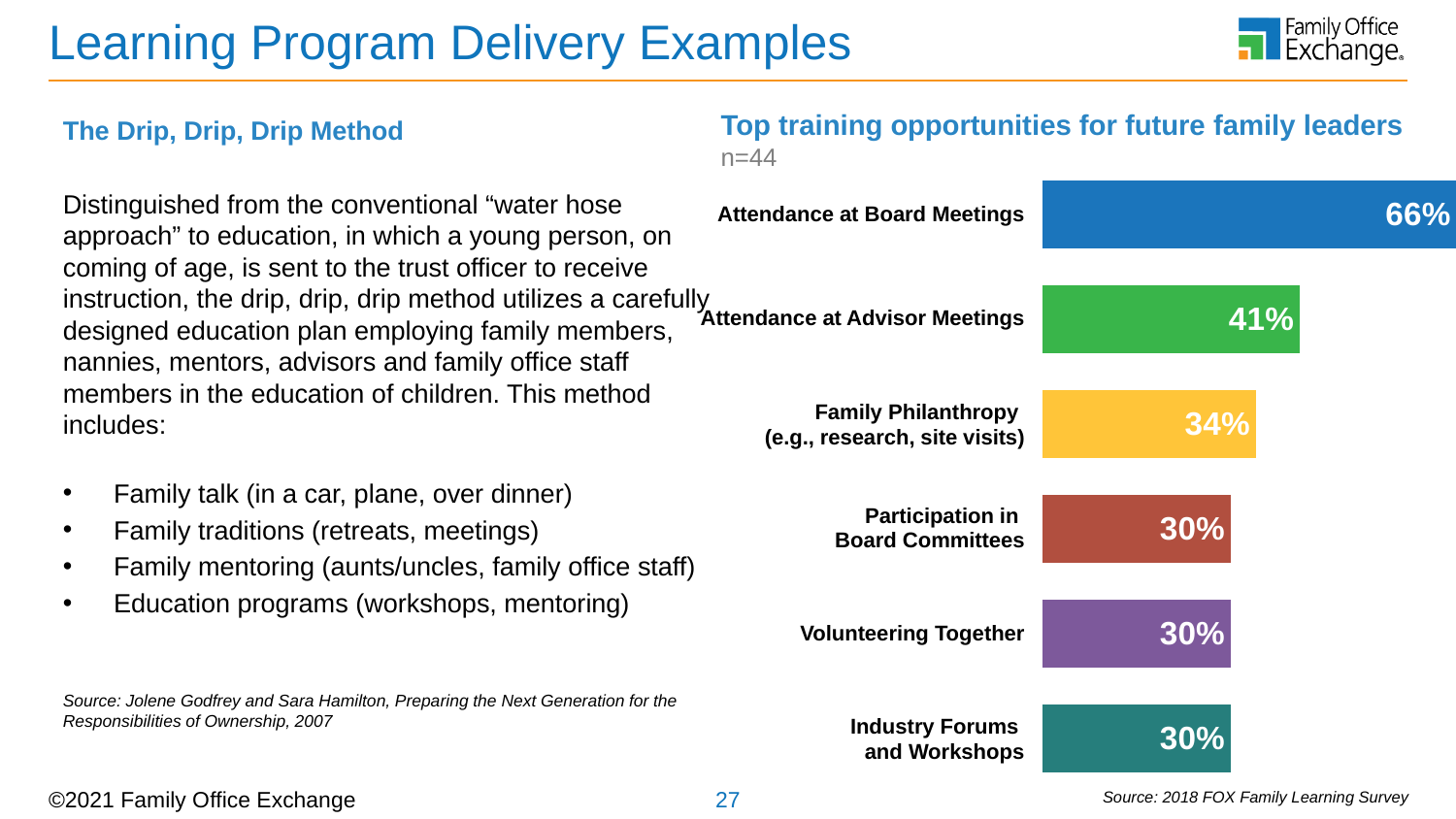
Which training opportunity has the highest percentage? Attendance at Board Meetings What is the value for Attendance at Advisor Meetings? 41% What is the value for Volunteering Together? 30% What is the difference between Family Philanthropy and Participation in Board Committees? 4% What percentage is shown for Attendance at Board Meetings? 66% How many categories share the lowest value of 30%? 3 What is the difference between Attendance at Board Meetings and Attendance at Advisor Meetings? 25% How many training opportunities are shown in the chart? 6 What percentage is shown for Family Philanthropy (e.g., research, site visits)? 34% What kind of chart is used to show the top training opportunities? Bar chart Which is larger, Attendance at Advisor Meetings or Family Philanthropy? Attendance at Advisor Meetings What is the sample size (n) stated under the chart title? n=44